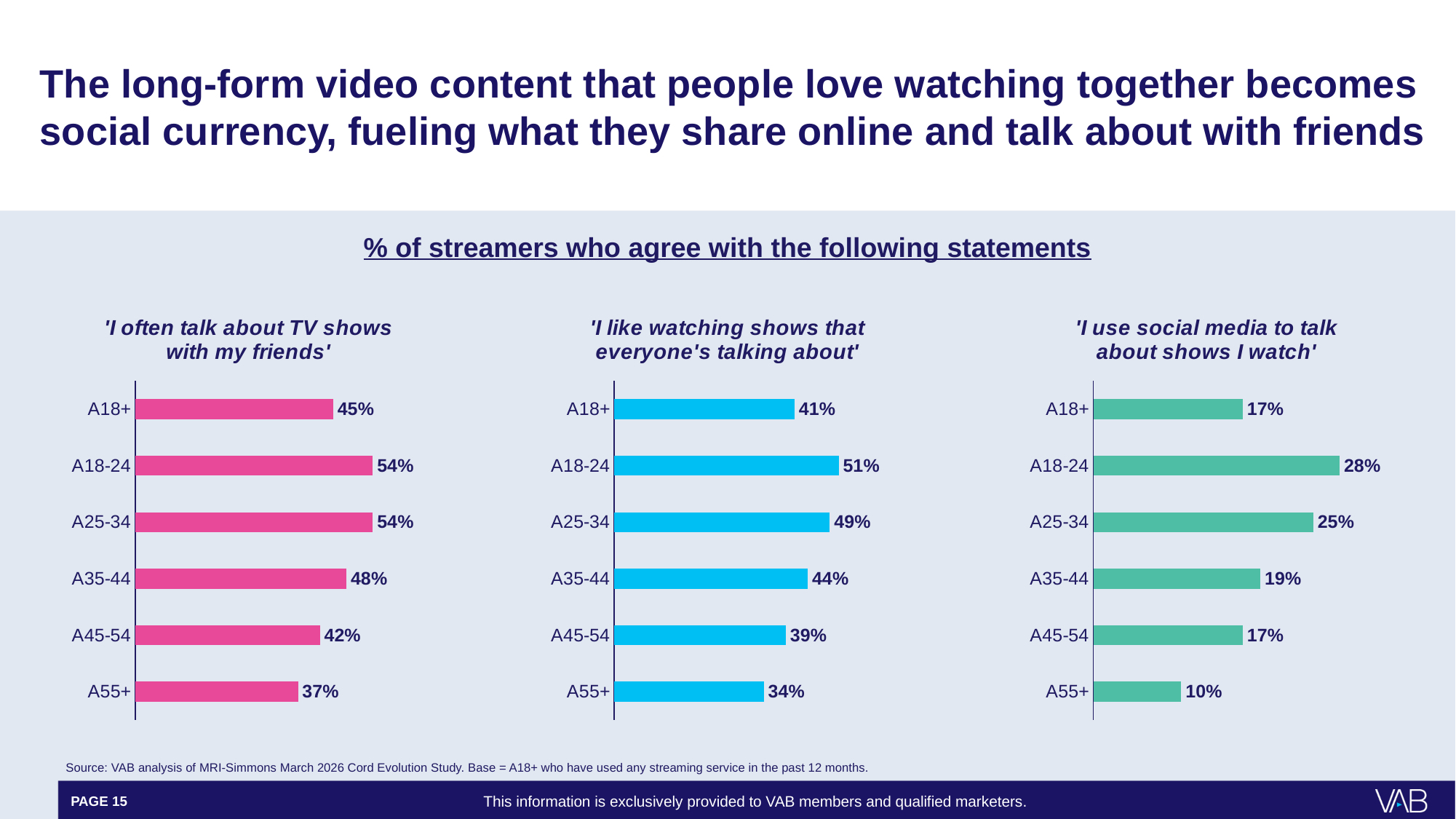
In the 'I use social media to talk about shows I watch' chart, what is the difference between the values for A25-34 and A45-54? 8% How many age groups are shown in the 'I often talk about TV shows with my friends' chart? 6 In the 'I often talk about TV shows with my friends' chart, what is the value for A35-44? 48% In the 'I like watching shows that everyone's talking about' chart, do the values rise or fall from A18-24 to A55+? Fall In the 'I like watching shows that everyone's talking about' chart, what is the value for A18+? 41% In the 'I often talk about TV shows with my friends' chart, what is the difference between the values for A18-24 and A55+? 17% What kind of chart is the 'I use social media to talk about shows I watch' chart? Bar chart In the 'I like watching shows that everyone's talking about' chart, which age group has the highest value? A18-24 In the 'I use social media to talk about shows I watch' chart, which age group has the lowest value? A55+ In the 'I like watching shows that everyone's talking about' chart, which is larger, the value for A25-34 or the value for A35-44? A25-34 In the 'I use social media to talk about shows I watch' chart, what is the value for A18-24? 28% What colour are the bars in the 'I often talk about TV shows with my friends' chart? Pink